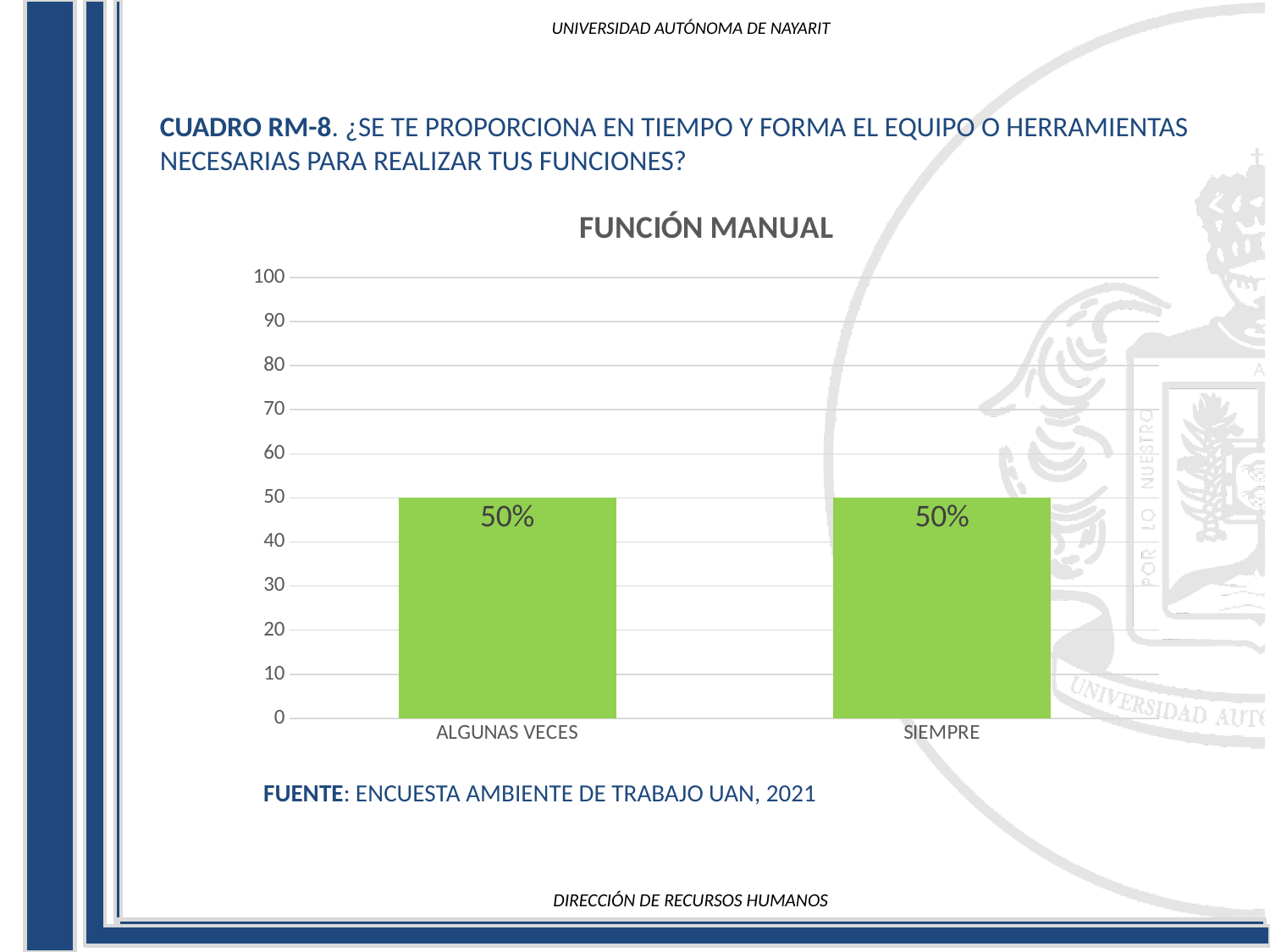
What is the value for ALGUNAS VECES? 50% Is the value for ALGUNAS VECES greater or less than 40? greater What is the highest value shown on the y axis? 100 What kind of chart is shown on the slide? bar chart What is the value for SIEMPRE? 50% Do the values rise, fall or stay the same from ALGUNAS VECES to SIEMPRE? stay the same How many categories are shown on the x axis? 2 What is the difference between the values for ALGUNAS VECES and SIEMPRE? 0% Is the value for SIEMPRE greater or less than 60? less What is the title of the chart? FUNCIÓN MANUAL